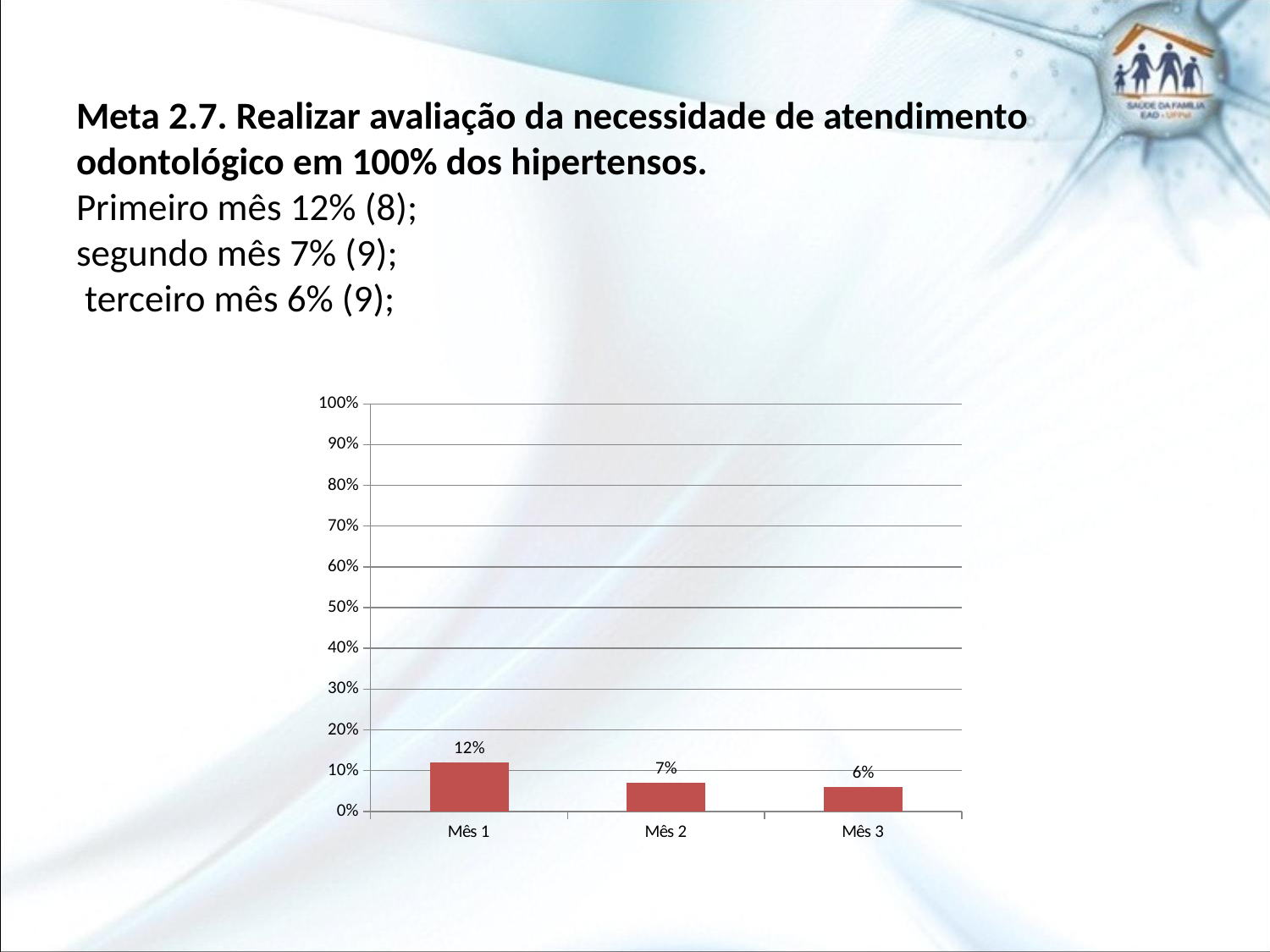
Is the value for Mês 1 greater or less than 10%? greater What is the value for Mês 2? 7% What is the value for Mês 3? 6% Which month has the highest value? Mês 1 What is the value for Mês 1? 12% Which is larger, the value for Mês 1 or the value for Mês 2? Mês 1 What kind of chart is shown on the slide? bar chart What is the difference between the values for Mês 1 and Mês 3? 6% How many categories are shown on the x axis? 3 What is the difference between the values for Mês 1 and Mês 2? 5% Which month has the lowest value? Mês 3 Do the values rise or fall from Mês 1 to Mês 3? fall